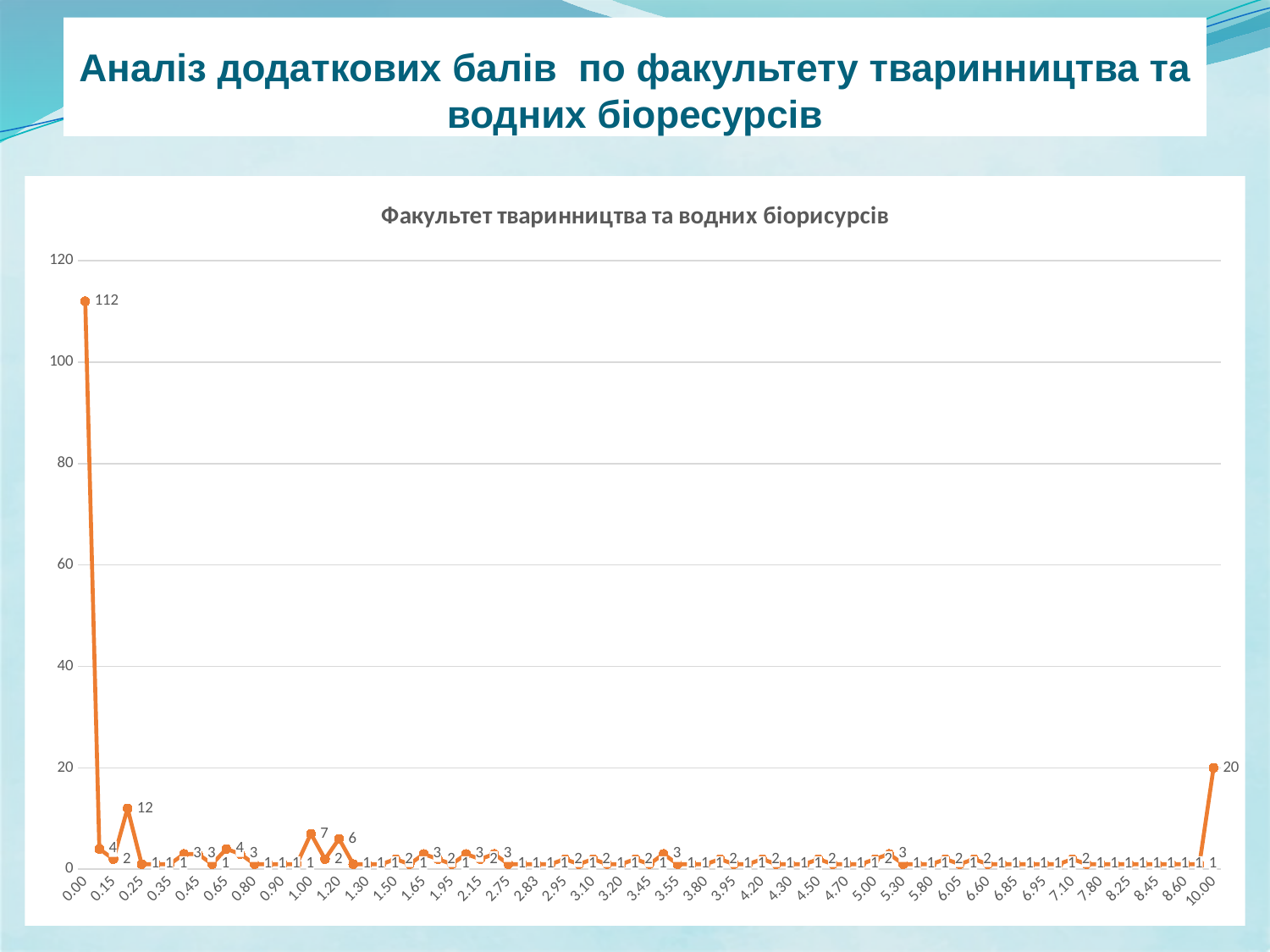
Which has the larger value, 0.00 or 10.00? 0.00 What is the value plotted at 0.00? 112 Which category has the highest value? 0.00 What is the maximum value shown on the vertical axis? 120 What is the title of the chart? Факультет тваринництва та водних біорисурсів What is the value plotted at 10.00? 20 What kind of chart is shown on the slide? line chart Is the value for 0.00 greater or less than 100? greater What is the second highest value labelled on the chart? 20 What is the difference between the values at 0.00 and 10.00? 92 Is the value for 10.00 greater or less than 40? less What is the highest value shown on the chart? 112